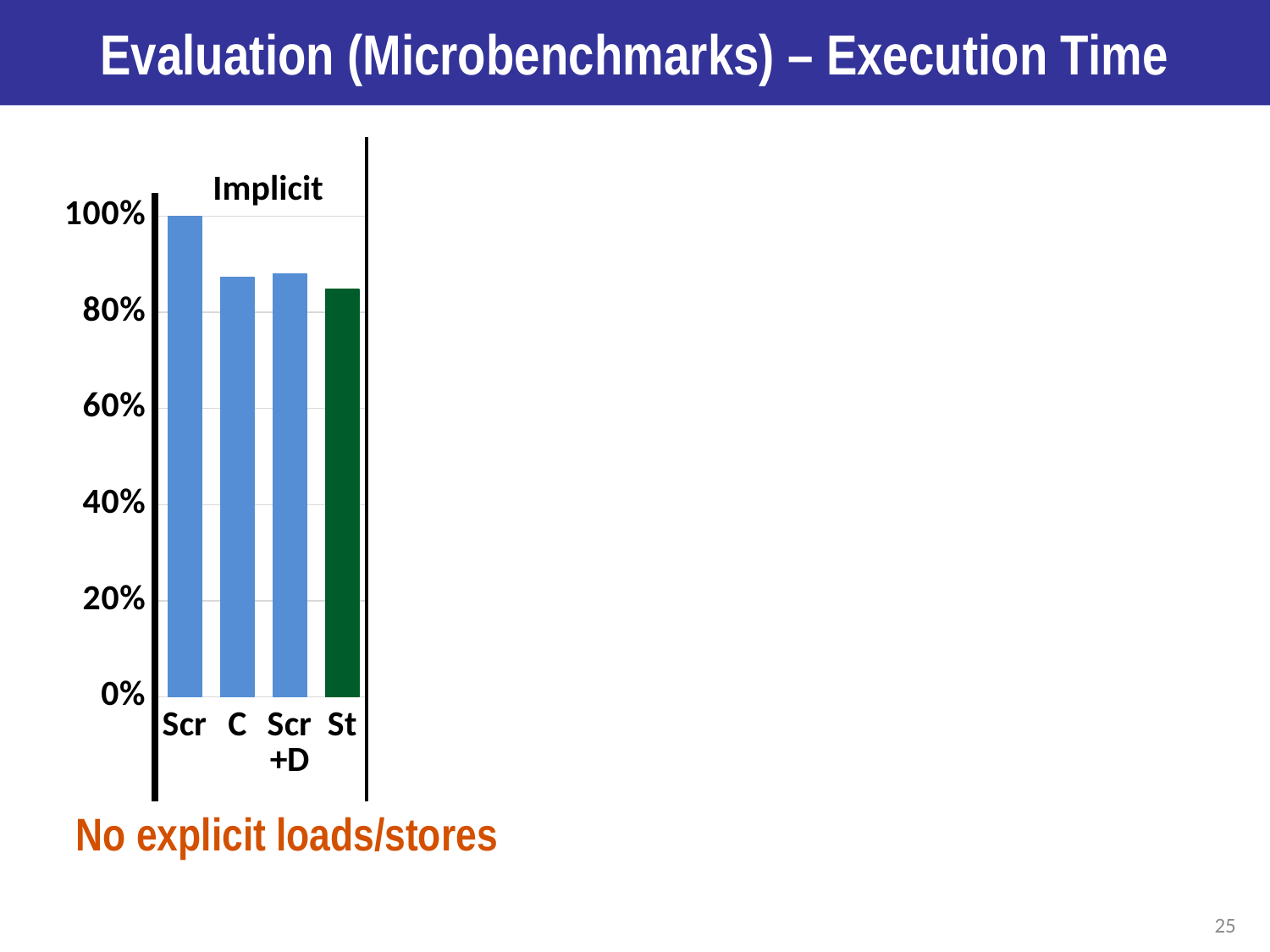
Is the value for St greater or less than 60%? greater Which category has the highest value in the Implicit chart? Scr What is the title of the chart? Implicit Which is larger, the value for Scr or the value for C? Scr Is the value for St greater or less than 80%? greater Is the value for Scr+D greater or less than 80%? greater What kind of chart is shown on the slide? bar chart Which is larger, the value for Scr or the value for St? Scr What is the value for Scr in the Implicit chart? 100% How many categories are shown in the chart? 4